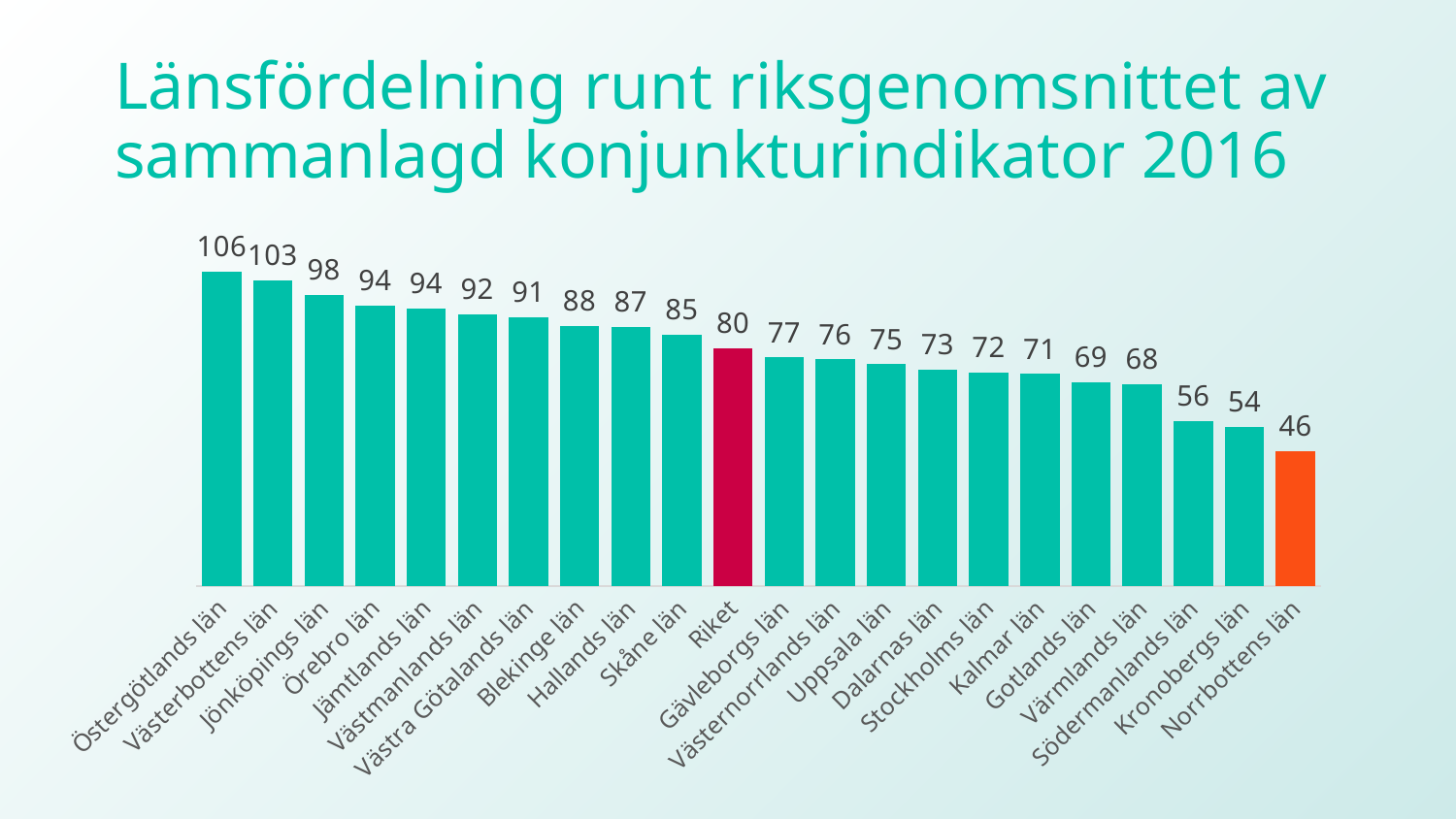
What is the difference between the values for Skåne län and Riket? 5 What kind of chart is shown on the slide? Bar chart Which category has the highest value? Östergötlands län Which bar is coloured red in the chart? Riket What is the value for Stockholms län? 72 Which is larger, the value for Uppsala län or the value for Kalmar län? Uppsala län Which category has the lowest value? Norrbottens län Do the values rise or fall from left to right along the x axis? Fall What is the value for Riket? 80 What is the value for Västra Götalands län? 91 What is the difference between the values for Östergötlands län and Norrbottens län? 60 How many bars are shown in the chart? 22